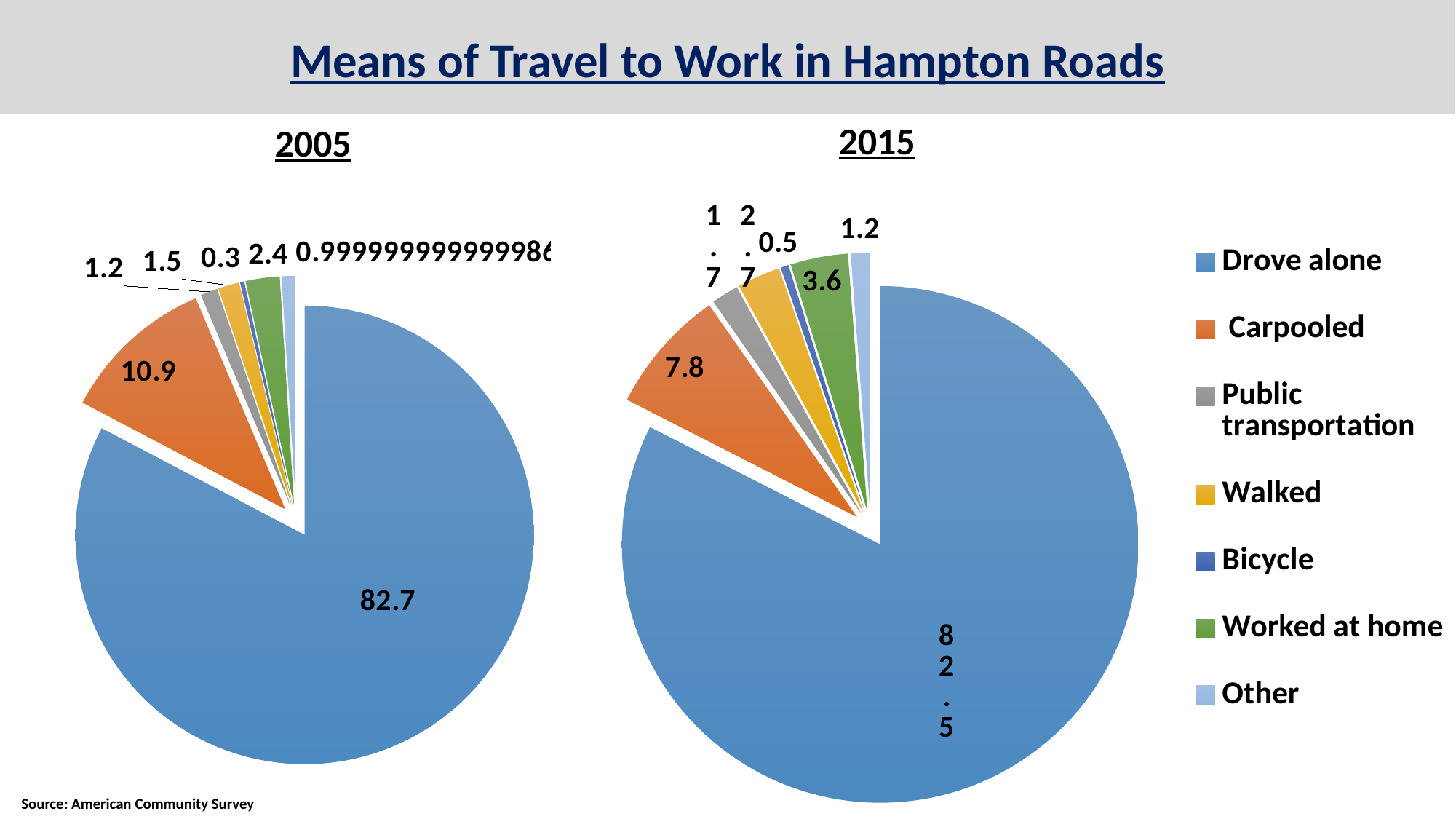
In the 2015 pie chart, what is the value for Carpooled? 7.8 In the 2005 pie chart, what is the value for Drove alone? 82.7 In the 2015 pie chart, which category has the smallest slice? Bicycle How many categories does the legend list for the pie charts? 7 In the 2005 pie chart, what is the value for Walked? 1.5 What is the difference between the Carpooled value in the 2005 chart and the Carpooled value in the 2015 chart? 3.1 In the 2015 pie chart, what is the value for Worked at home? 3.6 In the 2015 pie chart, what is the value for Public transportation? 1.7 Which is larger: Worked at home in the 2005 chart or Worked at home in the 2015 chart? 2015 Which colour represents Walked in the legend? Yellow In the 2005 pie chart, which category has the largest slice? Drove alone What type of chart is used to show the 2015 data? Pie chart